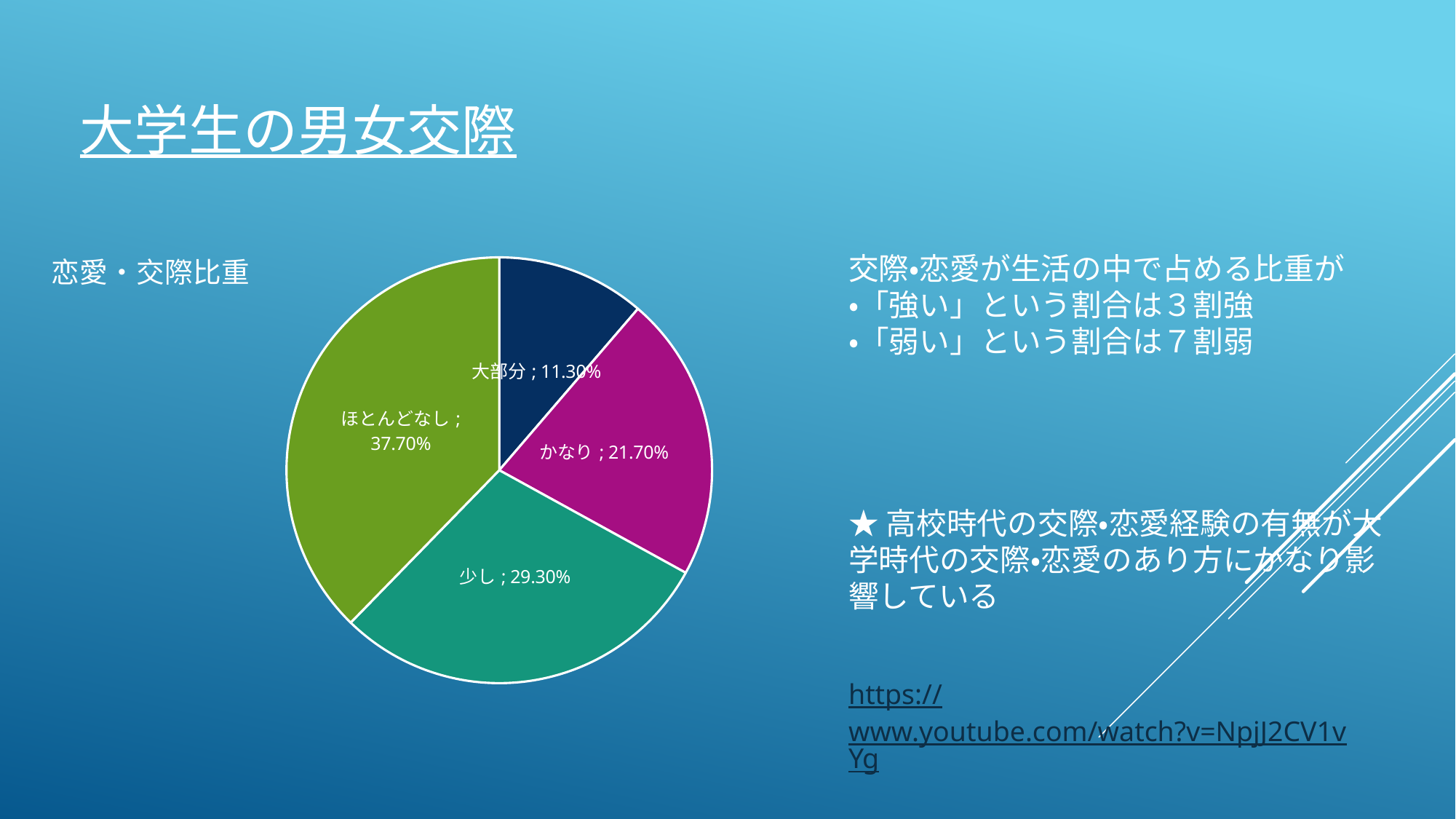
How many slices does the pie chart have? 4 What share of the pie is かなり? 21.70% What share of the pie is ほとんどなし? 37.70% What kind of chart is shown on the slide? pie chart What is the difference between the shares of ほとんどなし and 大部分? 26.40% Which is larger, the share of かなり or the share of 少し? 少し What colour is the ほとんどなし slice? green Which slice is the smallest? 大部分 Which slice is the largest? ほとんどなし What share of the pie is 大部分? 11.30% What share of the pie is 少し? 29.30% What is the title of the chart? 恋愛・交際比重